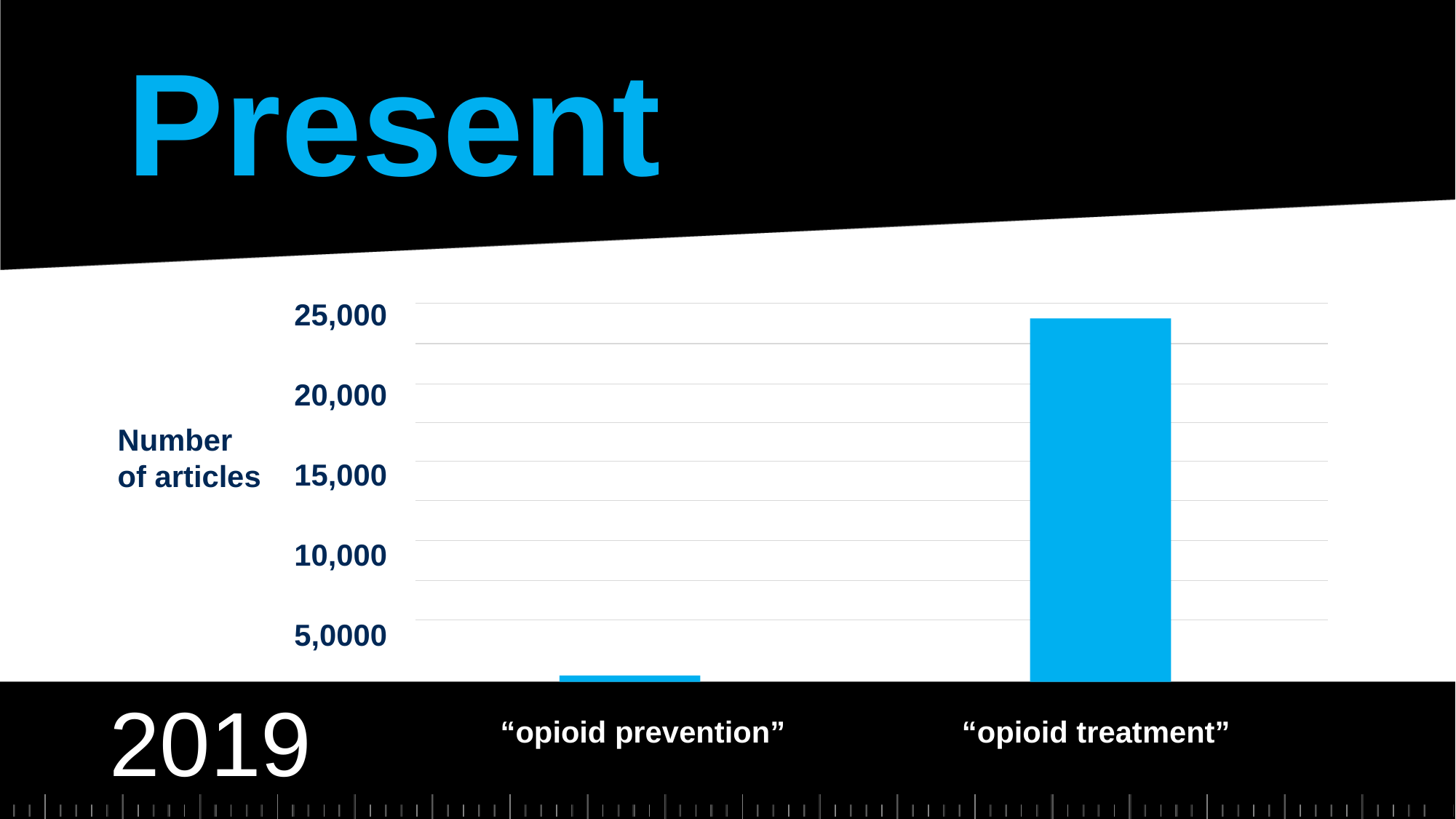
How many categories are plotted in the chart? 2 Which category has the highest number of articles? "opioid treatment" Is the number of articles for "opioid prevention" greater or less than 10,000? less What kind of chart is shown on the slide? bar chart Is the number of articles for "opioid treatment" greater or less than 20,000? greater What does the vertical axis of the chart measure? Number of articles Is the number of articles for "opioid treatment" greater or less than 15,000? greater Which category has the lowest number of articles? "opioid prevention" What year is shown next to the chart? 2019 Which has more articles, "opioid prevention" or "opioid treatment"? "opioid treatment"